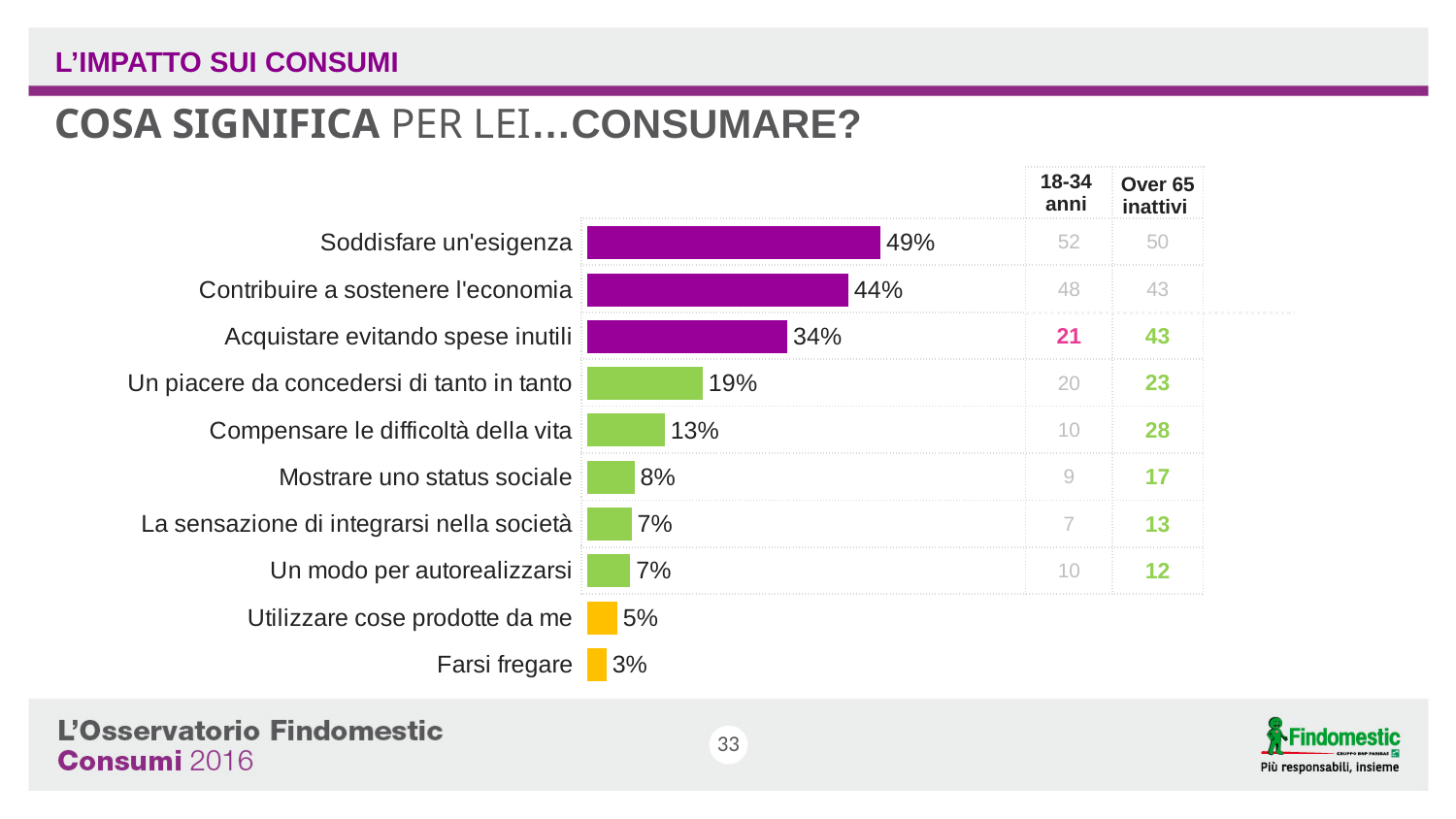
What is the value for "Soddisfare un'esigenza"? 49% Which is larger, "Un piacere da concedersi di tanto in tanto" or "Mostrare uno status sociale"? Un piacere da concedersi di tanto in tanto Do the values rise or fall going down the list of categories? Fall What kind of chart is shown on the slide? Bar chart How many categories are shown in the chart? 10 What is the value for "Compensare le difficoltà della vita"? 13% What is the value for "Acquistare evitando spese inutili" in the "Over 65 inattivi" column? 43 What colour are the bars for "Utilizzare cose prodotte da me" and "Farsi fregare"? Yellow What is the value for "Utilizzare cose prodotte da me"? 5% Which category has the lowest value? Farsi fregare Which category has the highest value? Soddisfare un'esigenza What is the difference between "Contribuire a sostenere l'economia" and "Acquistare evitando spese inutili"? 10%